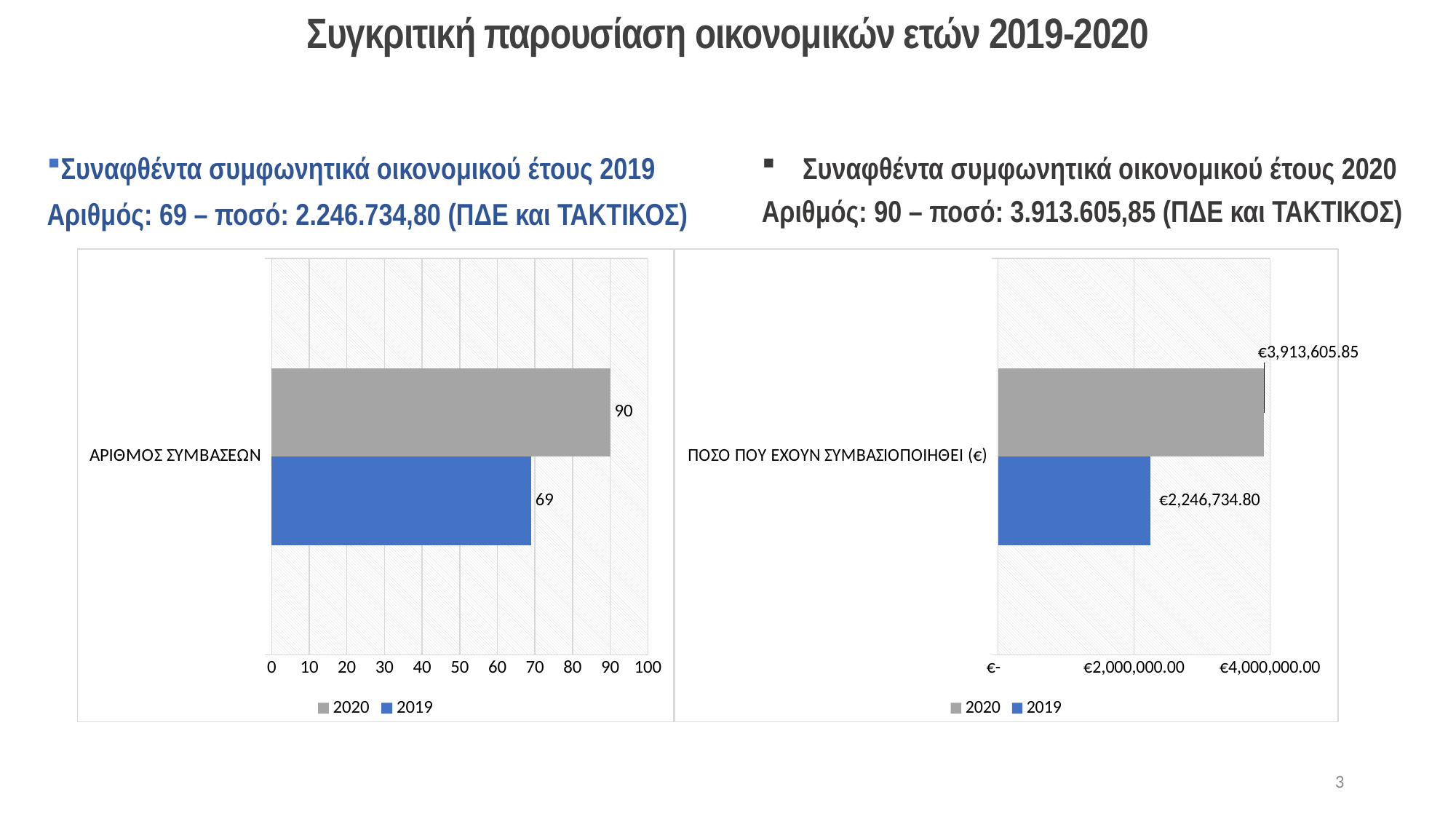
In the left chart (ΑΡΙΘΜΟΣ ΣΥΜΒΑΣΕΩΝ), what is the value for 2019? 69 In the left chart (ΑΡΙΘΜΟΣ ΣΥΜΒΑΣΕΩΝ), which year has the larger value, 2019 or 2020? 2020 In the right chart (ΠΟΣΟ ΠΟΥ ΕΧΟΥΝ ΣΥΜΒΑΣΙΟΠΟΙΗΘΕΙ (€)), what is the difference between the 2020 and 2019 values? €1,666,871.05 In the right chart (ΠΟΣΟ ΠΟΥ ΕΧΟΥΝ ΣΥΜΒΑΣΙΟΠΟΙΗΘΕΙ (€)), what is the value for 2020? €3,913,605.85 In the left chart (ΑΡΙΘΜΟΣ ΣΥΜΒΑΣΕΩΝ), what is the difference between the 2020 and 2019 values? 21 In the left chart (ΑΡΙΘΜΟΣ ΣΥΜΒΑΣΕΩΝ), what is the value for 2020? 90 What kind of chart is the right chart (ΠΟΣΟ ΠΟΥ ΕΧΟΥΝ ΣΥΜΒΑΣΙΟΠΟΙΗΘΕΙ (€))? Bar chart In the right chart (ΠΟΣΟ ΠΟΥ ΕΧΟΥΝ ΣΥΜΒΑΣΙΟΠΟΙΗΘΕΙ (€)), what is the value for 2019? €2,246,734.80 In the right chart (ΠΟΣΟ ΠΟΥ ΕΧΟΥΝ ΣΥΜΒΑΣΙΟΠΟΙΗΘΕΙ (€)), which year has the smaller value? 2019 How many series does the legend of the left chart (ΑΡΙΘΜΟΣ ΣΥΜΒΑΣΕΩΝ) list? 2 In the left chart (ΑΡΙΘΜΟΣ ΣΥΜΒΑΣΕΩΝ), which colour represents the 2019 series? Blue In the right chart (ΠΟΣΟ ΠΟΥ ΕΧΟΥΝ ΣΥΜΒΑΣΙΟΠΟΙΗΘΕΙ (€)), is the value for 2019 greater or less than €2,000,000.00? greater